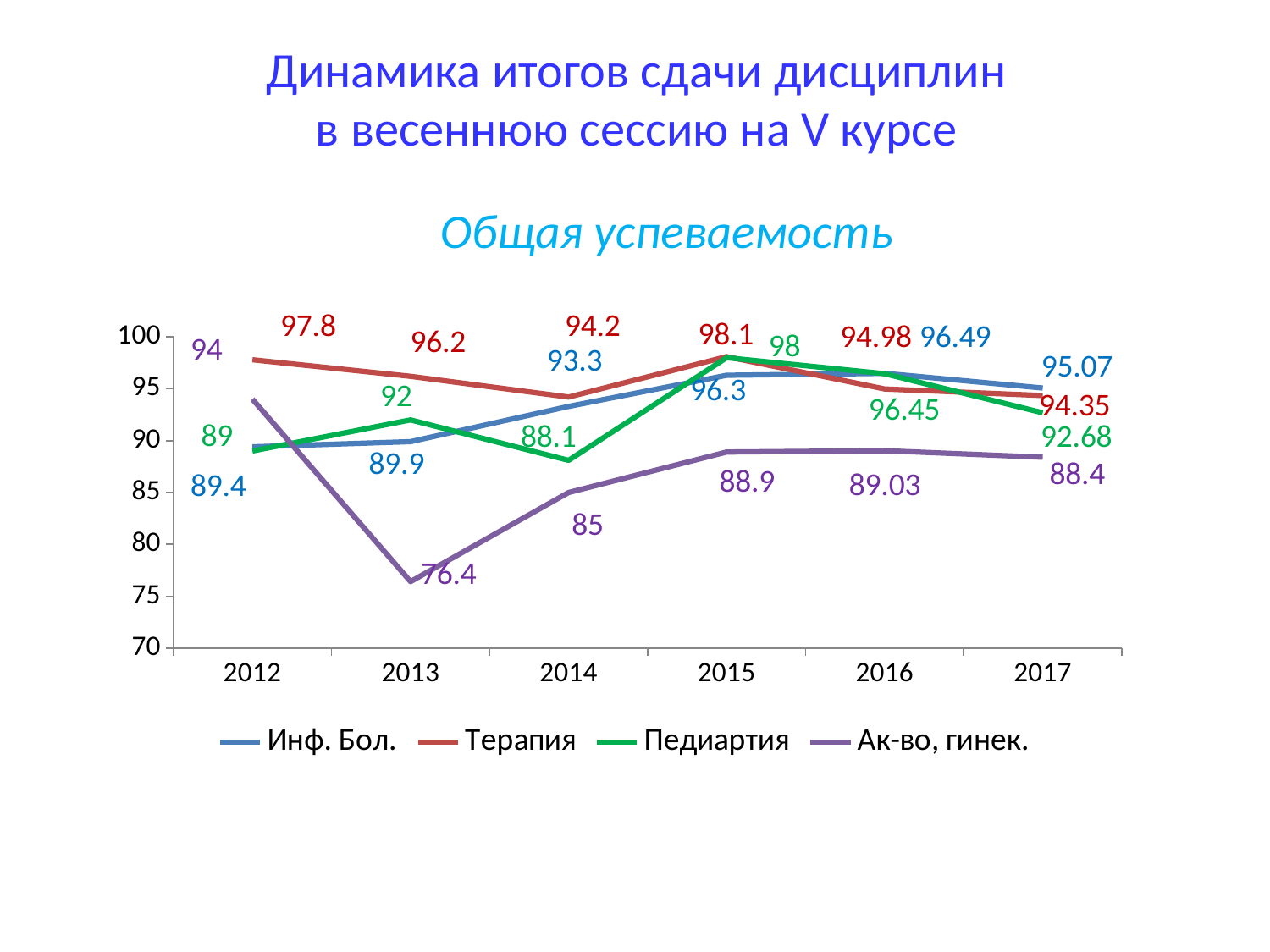
How many series does the legend list? 4 Which is larger in 2014: the value for Инф. Бол. or the value for Педиартия? Инф. Бол. What is the value for Ак-во, гинек. in 2013? 76.4 In which year is the value for Терапия highest? 2015 What kind of chart is shown on the slide? Line chart What is the difference between the Терапия and Инф. Бол. values in 2012? 8.4 What is the value for Терапия in 2012? 97.8 How many years are shown on the x axis? 6 In which year is the value for Ак-во, гинек. lowest? 2013 What is the value for Инф. Бол. in 2017? 95.07 What is the value for Педиартия in 2015? 98 What is the title of the chart? Общая успеваемость